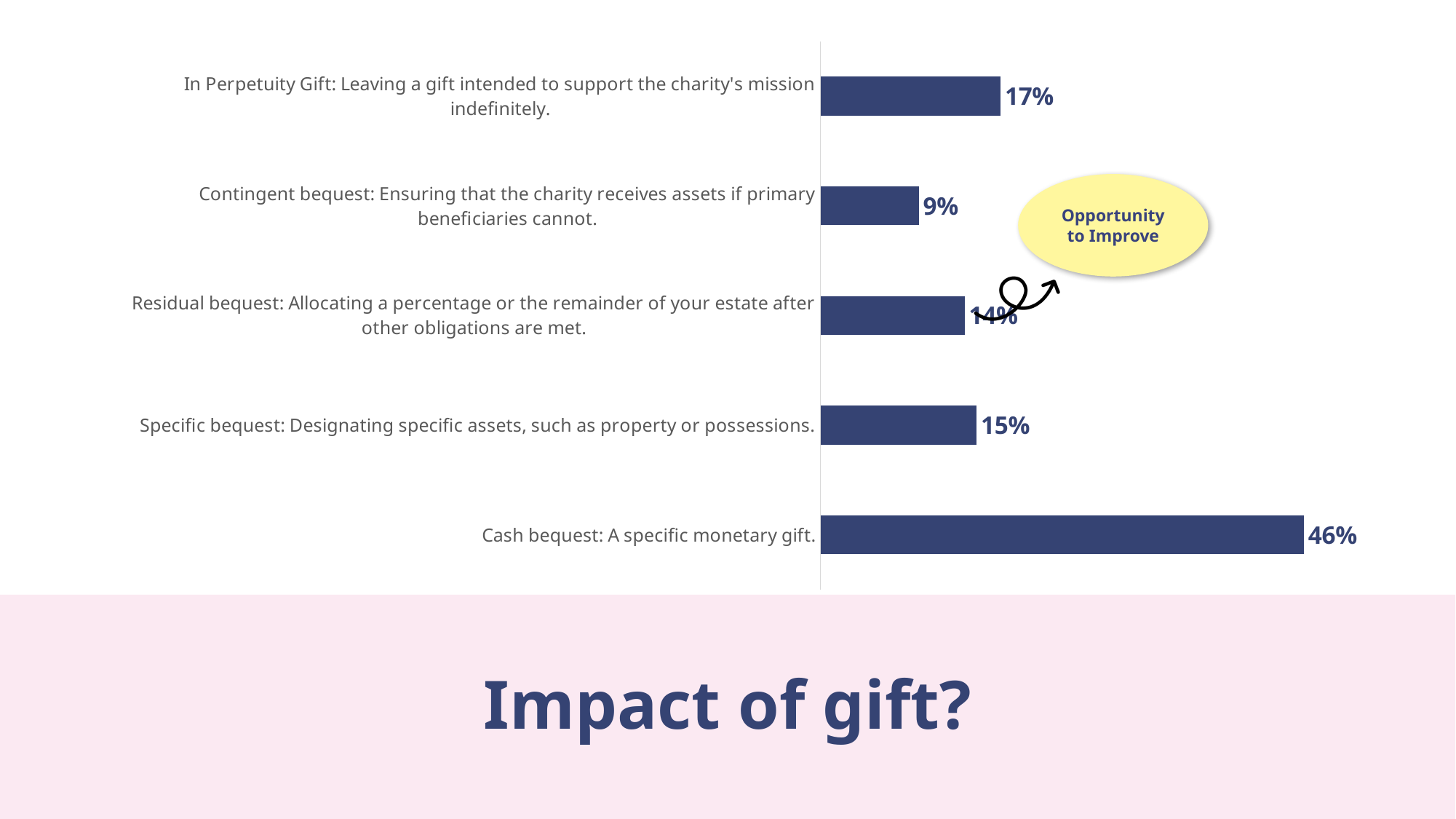
What type of chart is shown on the slide? Bar chart What is the value for Contingent bequest? 9% What is the value for In Perpetuity Gift? 17% What is the value for Cash bequest? 46% Which is larger, the value for Cash bequest or the value for Residual bequest? Cash bequest What is the difference between the values for Cash bequest and In Perpetuity Gift? 29% Which is larger, the value for Specific bequest or the value for Contingent bequest? Specific bequest What is the value for Specific bequest? 15% How many categories are shown in the chart? 5 What is the difference between the values for In Perpetuity Gift and Contingent bequest? 8% Which category has the lowest value? Contingent bequest Which category has the highest value? Cash bequest